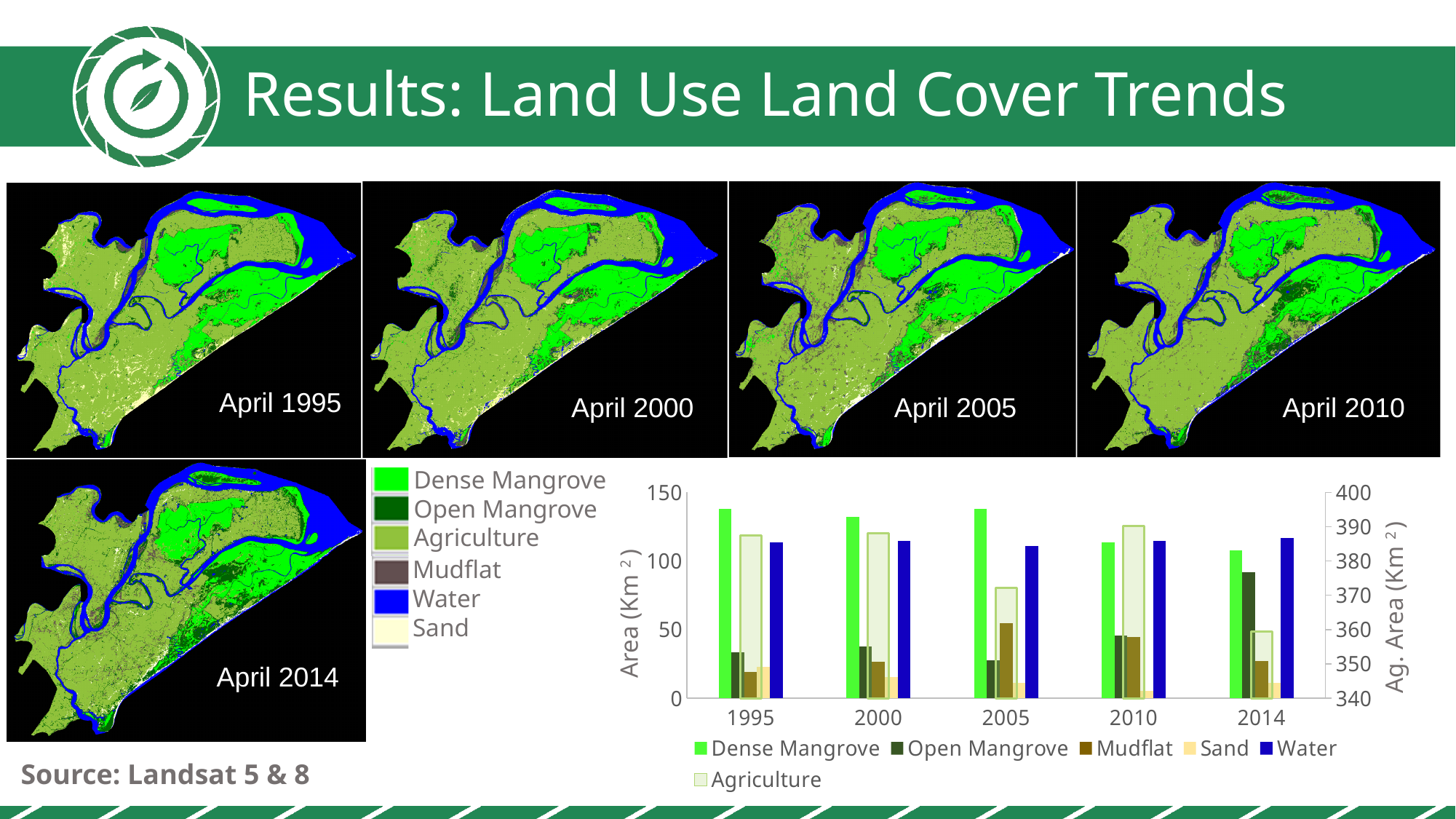
In which year is the Agriculture area lowest? 2014 In which year is the Sand area lowest? 2010 Is the Agriculture value for 2014 greater or less than 380 on the right axis? less Is the Dense Mangrove value for 1995 greater or less than 100? greater In which year is the Open Mangrove area highest? 2014 In 2014, which is larger: Open Mangrove or Mudflat? Open Mangrove How many series does the bar chart's legend list? 6 Is the Open Mangrove value for 2014 greater or less than 50? greater How many years are shown on the x axis of the bar chart? 5 Does the Dense Mangrove area generally rise or fall from 1995 to 2014? fall In which year is the Mudflat area highest? 2005 What kind of chart is shown on the slide? bar chart